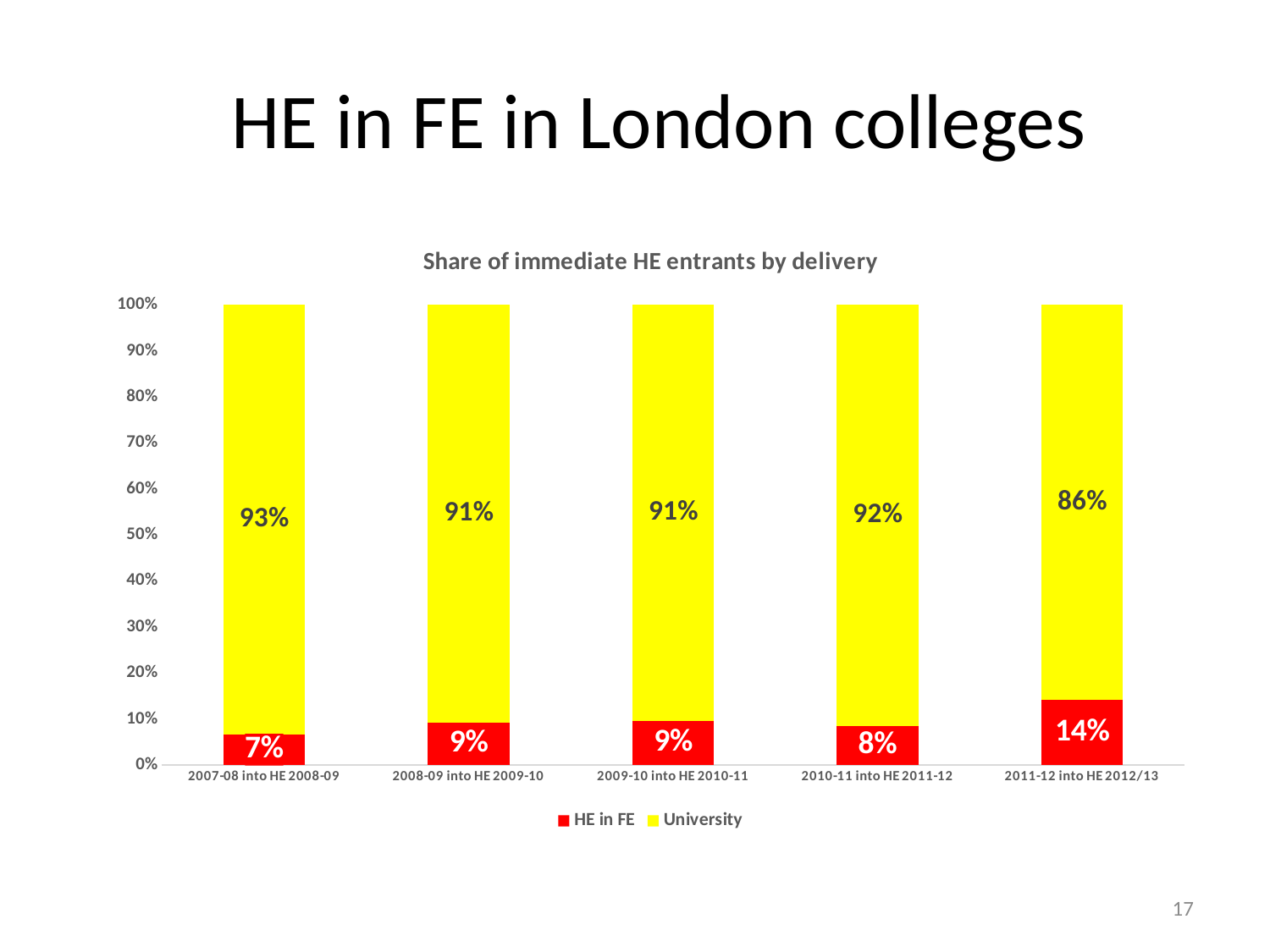
Which category has the highest HE in FE share? 2011-12 into HE 2012/13 Which category has the lowest HE in FE share? 2007-08 into HE 2008-09 What is the HE in FE share for 2010-11 into HE 2011-12? 8% What is the total of the stacked bar for 2009-10 into HE 2010-11? 100% Which is larger: the HE in FE share for 2008-09 into HE 2009-10 or for 2010-11 into HE 2011-12? 2008-09 into HE 2009-10 How many categories are shown on the x axis? 5 How many series does the legend list? 2 What is the title of the chart? Share of immediate HE entrants by delivery What is the University share for 2007-08 into HE 2008-09? 93% What is the HE in FE share for 2011-12 into HE 2012/13? 14% What kind of chart is shown on the slide? Stacked bar chart What is the difference between the University share and the HE in FE share for 2011-12 into HE 2012/13? 72%